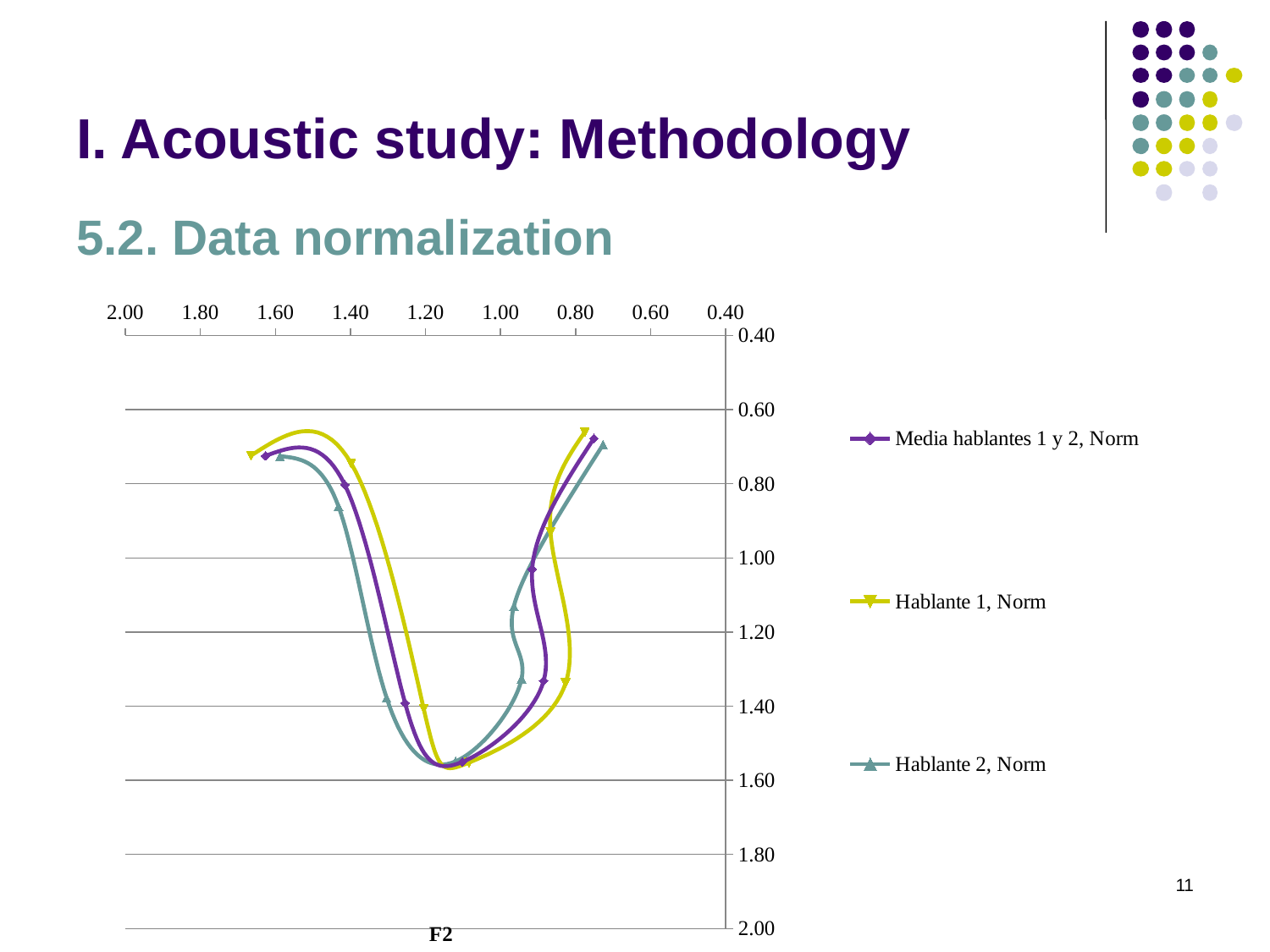
Is the smallest horizontal-axis (F2) value reached by the Hablante 2, Norm curve greater or less than 0.60? greater Is the smallest vertical-axis value reached by the Hablante 1, Norm curve greater or less than 0.40? greater What kind of chart is shown on the slide? Scatter chart with smoothed lines Which series in the chart is drawn in yellow? Hablante 1, Norm What is the title of the horizontal axis of the chart? F2 How many series does the chart legend list? 3 What is the highest value shown on the vertical axis of the chart? 2.00 Is the largest horizontal-axis (F2) value reached by the Hablante 1, Norm curve greater or less than 1.40? greater